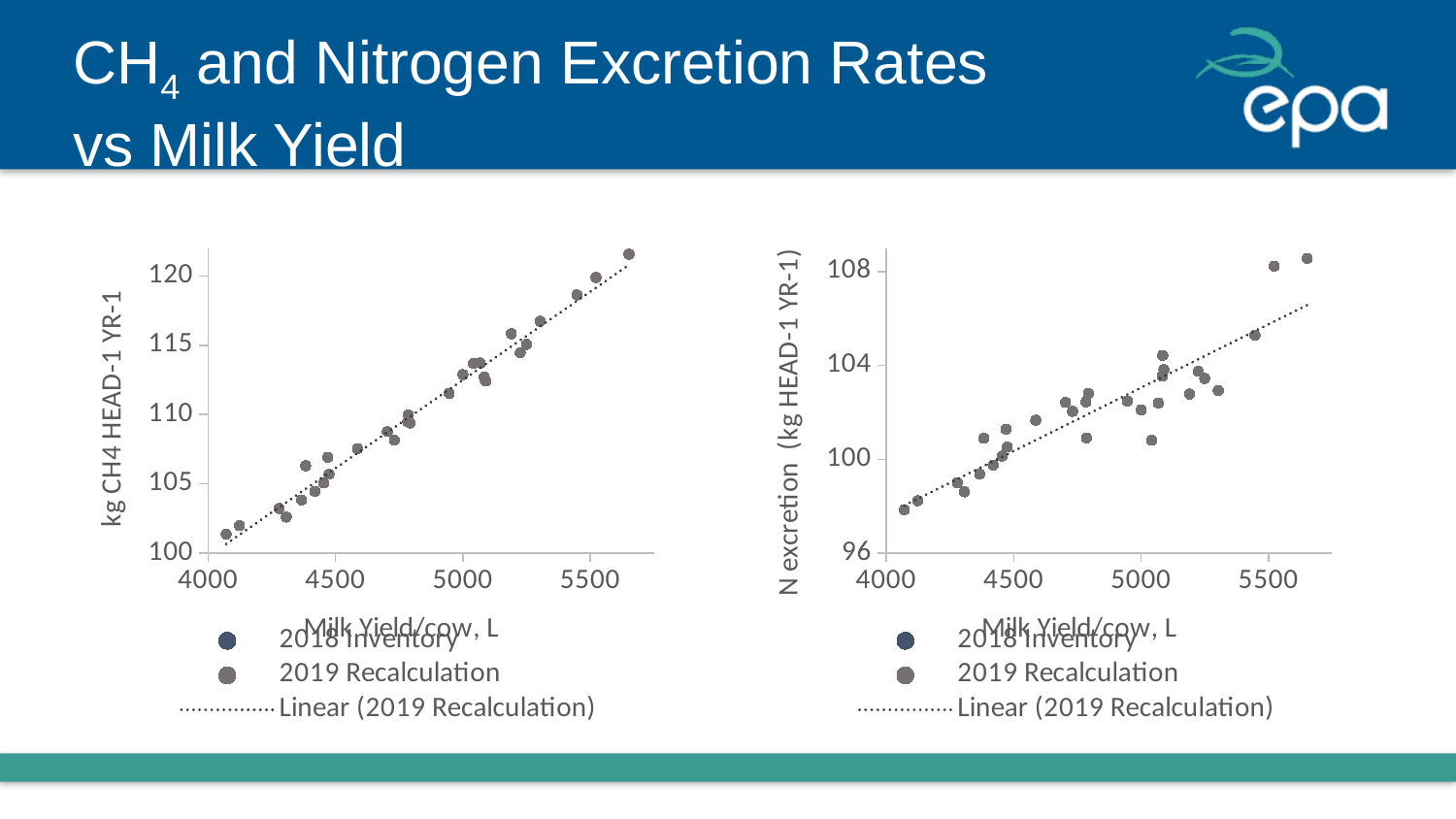
What kind of chart is the left chart (kg CH4 HEAD-1 YR-1 vs Milk Yield)? scatter chart How many entries does the legend of the left chart list? 3 In the right chart, is the N excretion value for the point with the lowest milk yield greater or less than 100? less In the left chart, do the kg CH4 values rise or fall as milk yield increases along the x axis? rise What is the x-axis title of the left chart? Milk Yield/cow, L In the right chart, do the N excretion values rise or fall as milk yield increases along the x axis? rise How many entries does the legend of the right chart list? 3 What is the y-axis title of the right chart? N excretion (kg HEAD-1 YR-1) What kind of chart is the right chart (N excretion vs Milk Yield)? scatter chart In the left chart, is the kg CH4 value for the point with the highest milk yield greater or less than 120? greater In the right chart, is the N excretion value for the point with the highest milk yield greater or less than 108? greater